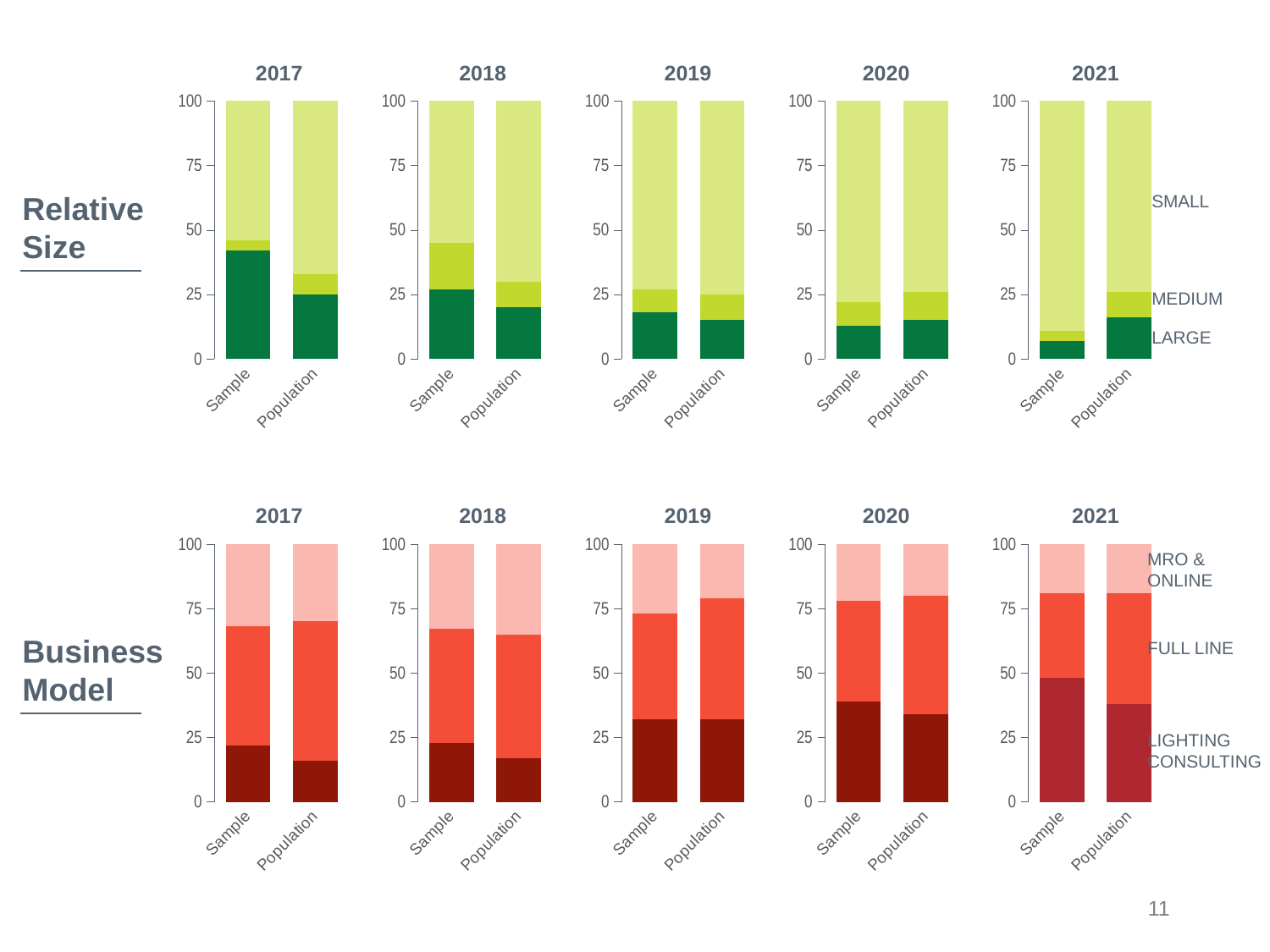
Across the Relative Size charts from 2017 to 2021, does the LARGE segment of the Sample bar rise or fall? fall In the Relative Size 2017 chart, is the LARGE segment of the Sample bar greater or less than 50? less In the Relative Size 2021 chart, is the LARGE segment of the Sample bar greater or less than 25? less How many bars are shown in the Relative Size 2019 chart? 2 How many segments (series) are labelled for the Business Model charts? 3 In the Relative Size 2017 chart, is the LARGE segment of the Sample bar greater or less than 25? greater Across the Business Model charts from 2017 to 2021, does the LIGHTING CONSULTING segment of the Sample bar rise or fall? rise In the Relative Size 2017 chart, which bar has the larger LARGE segment, Sample or Population? Sample In the Business Model 2021 chart, which bar has the larger LIGHTING CONSULTING segment, Sample or Population? Sample